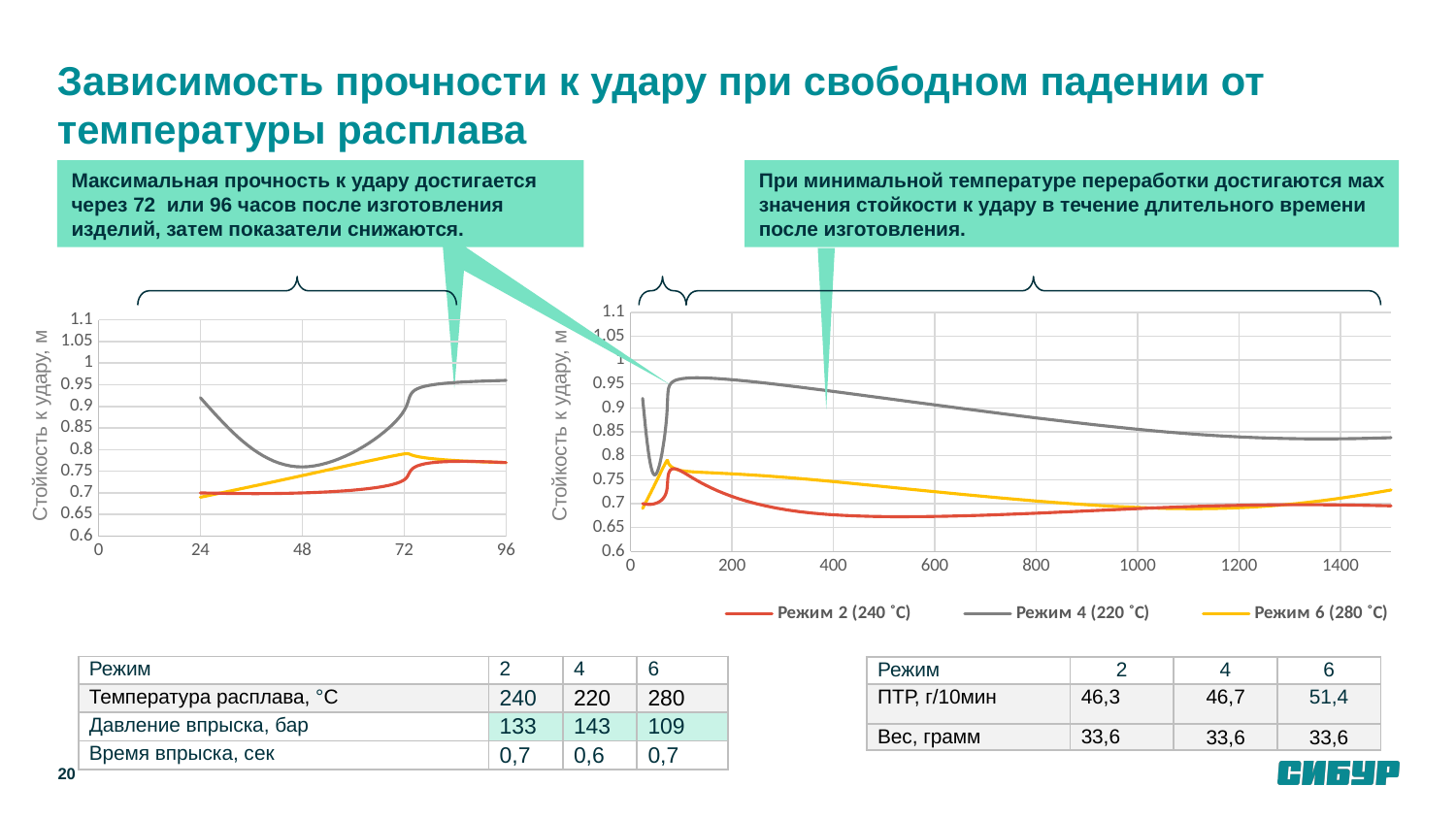
In the right chart, which series has the higher value at 1000: Режим 4 (220 °C) or Режим 6 (280 °C)? Режим 4 (220 °C) How many series does the legend list for the charts? 3 What kind of chart is the left chart on the slide? line chart In the left chart, which series has the higher value at 96: Режим 4 (220 °C) or Режим 2 (240 °C)? Режим 4 (220 °C) In the left chart, is the value for Режим 4 (220 °C) at 96 greater or less than 0.9? greater In the right chart, does the Режим 4 (220 °C) line rise or fall between 200 and 1400? fall What is the y-axis label of the right chart? Стойкость к удару, м Which series are listed in the legend? Режим 2 (240 °C), Режим 4 (220 °C), Режим 6 (280 °C) In the right chart, is the value for Режим 2 (240 °C) at 400 greater or less than 0.75? less In the right chart, is the value for Режим 4 (220 °C) at 1400 greater or less than 0.8? greater In the left chart, does the Режим 2 (240 °C) line rise or fall between 24 and 96? rise